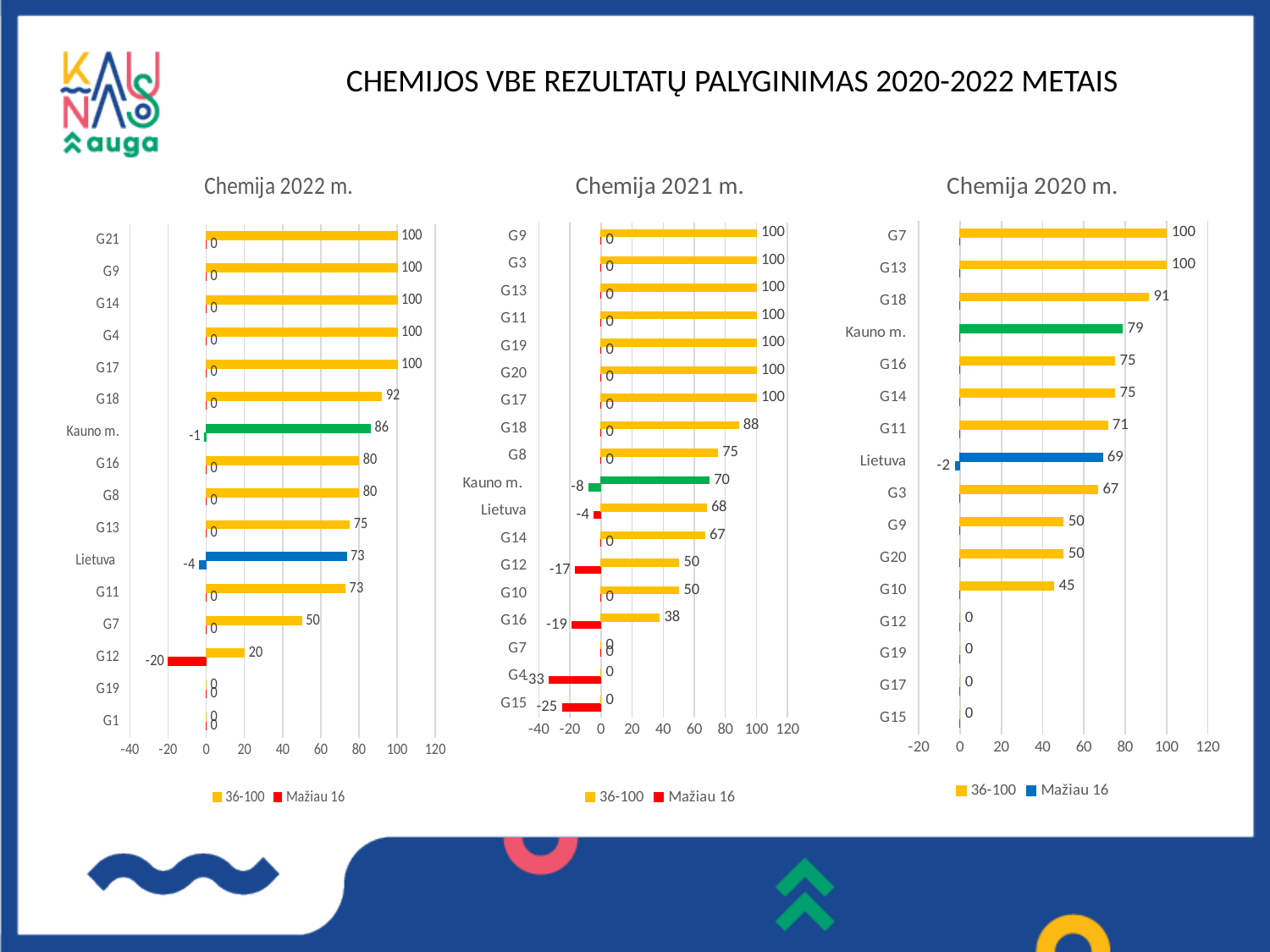
How many series does the legend of the Chemija 2020 m. chart list? 2 In the Chemija 2022 m. chart, what is the difference between the 36-100 values for Kauno m. and Lietuva? 13 In the Chemija 2022 m. chart, what is the Mažiau 16 value for G12? -20 In the Chemija 2020 m. chart, what is the value for G18? 91 In the Chemija 2020 m. chart, what is the value for G10? 45 In the Chemija 2022 m. chart, what is the 36-100 value for G18? 92 How many categories are shown in the Chemija 2021 m. chart? 18 In the Chemija 2021 m. chart, which has the larger 36-100 value, G18 or G8? G18 In the Chemija 2021 m. chart, what is the 36-100 value for Kauno m.? 70 In the Chemija 2021 m. chart, what is the Mažiau 16 value for G16? -19 What type of chart is the Chemija 2022 m. chart? Bar chart